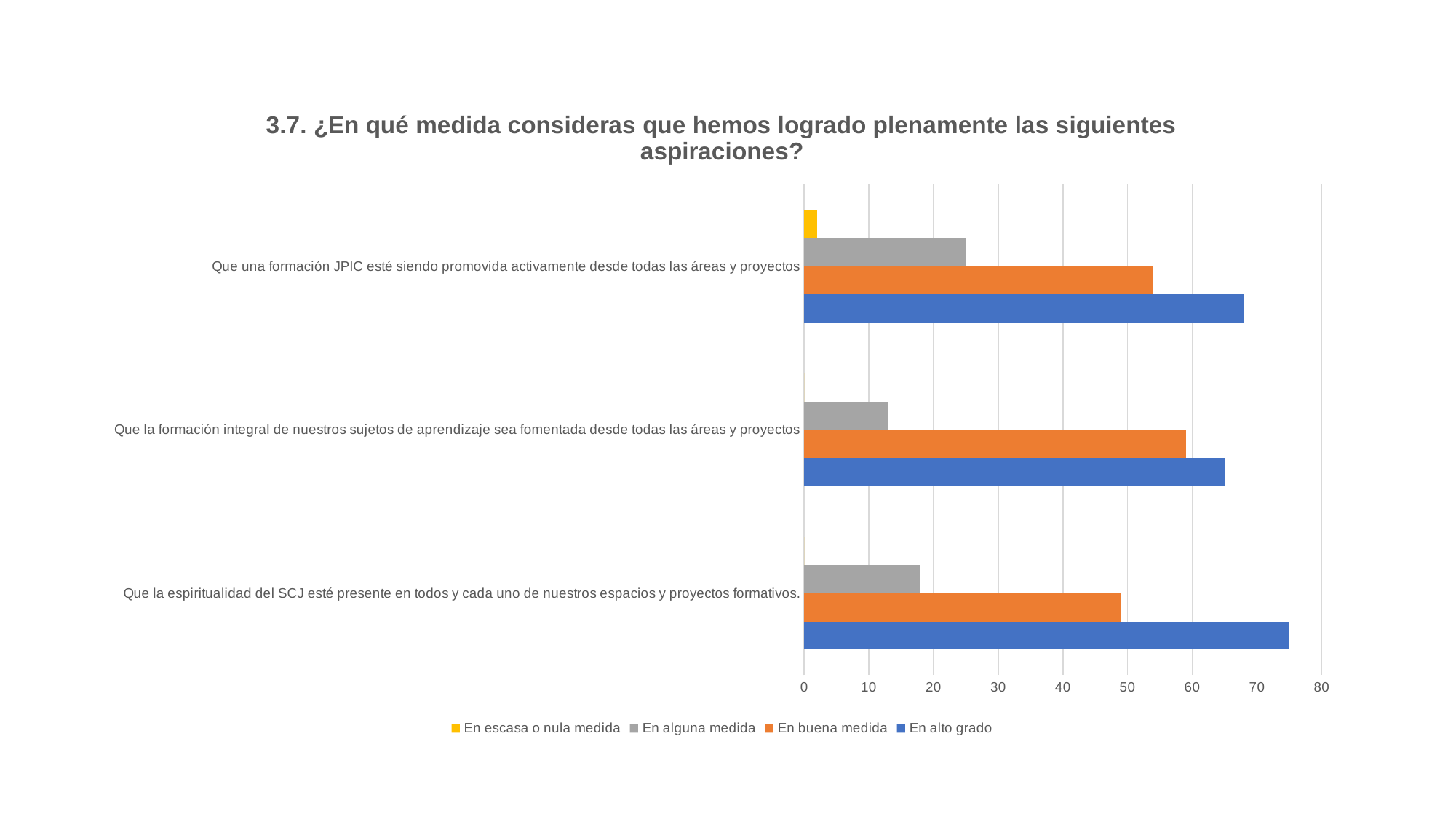
Is the 'En alto grado' value for 'Que una formación JPIC esté siendo promovida activamente desde todas las áreas y proyectos' greater or less than 60? greater What kind of chart is shown on the slide? Bar chart For 'En buena medida', which is larger: the value for 'Que la formación integral de nuestros sujetos de aprendizaje sea fomentada desde todas las áreas y proyectos' or for 'Que la espiritualidad del SCJ esté presente en todos y cada uno de nuestros espacios y proyectos formativos.'? Que la formación integral de nuestros sujetos de aprendizaje sea fomentada desde todas las áreas y proyectos Is the 'En buena medida' value for 'Que la formación integral de nuestros sujetos de aprendizaje sea fomentada desde todas las áreas y proyectos' greater or less than 50? greater Which category has the highest 'En alto grado' value? Que la espiritualidad del SCJ esté presente en todos y cada uno de nuestros espacios y proyectos formativos. Is the 'En alto grado' value for 'Que la espiritualidad del SCJ esté presente en todos y cada uno de nuestros espacios y proyectos formativos.' greater or less than 70? greater Which category has the lowest 'En alguna medida' value? Que la formación integral de nuestros sujetos de aprendizaje sea fomentada desde todas las áreas y proyectos Which series is shown in yellow in the legend? En escasa o nula medida How many aspiration categories are plotted on the chart? 3 How many series does the legend list? 4